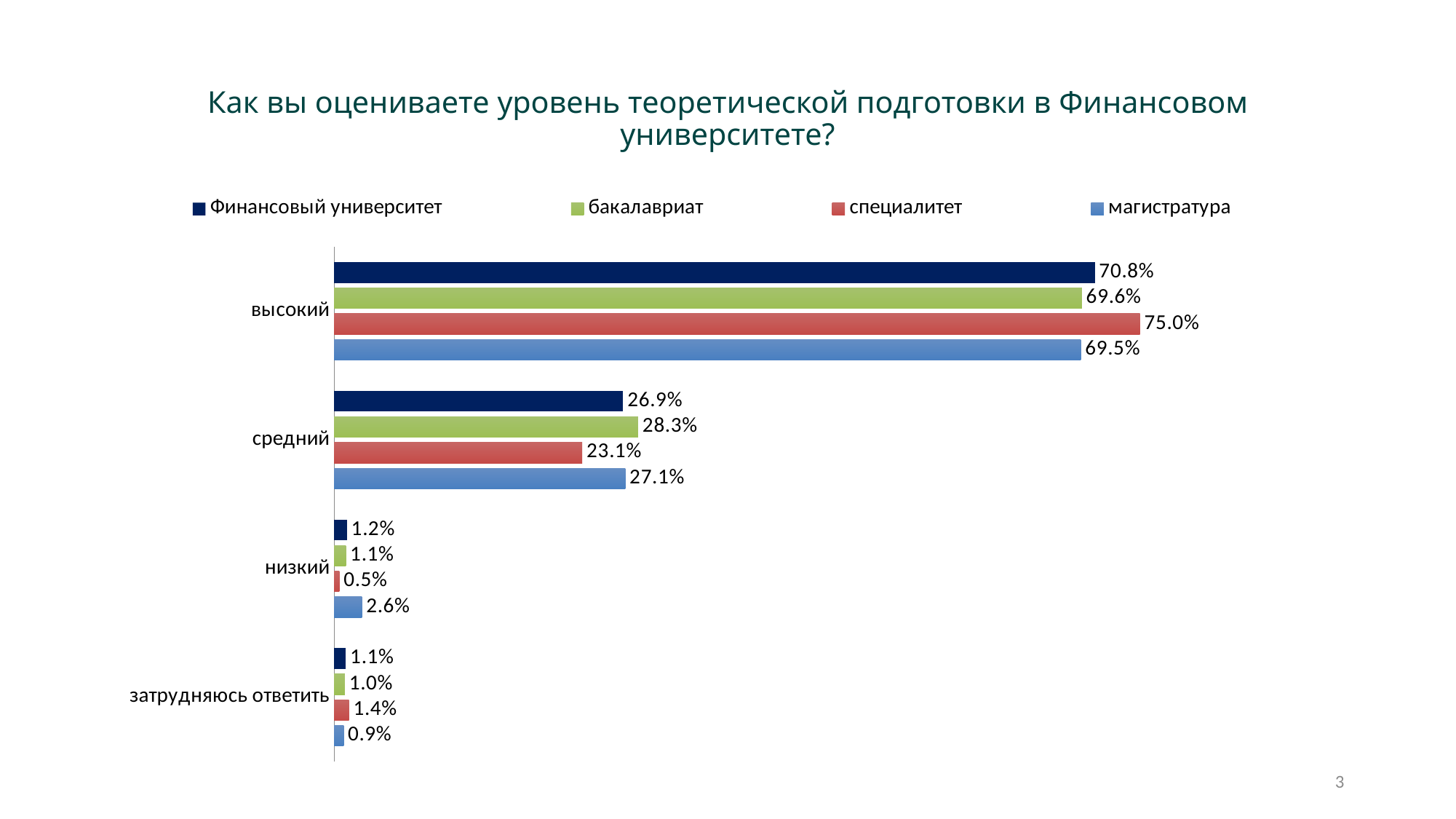
How many series does the legend list? 4 What kind of chart is shown on the slide? bar chart What is the value for специалитет in the высокий category? 75.0% Which series has the highest value in the высокий category? специалитет What is the value for бакалавриат in the низкий category? 1.1% Which series has the lowest value in the низкий category? специалитет What is the value for Финансовый университет in the затрудняюсь ответить category? 1.1% What is the difference between специалитет and бакалавриат in the высокий category? 5.4% Which is larger in the средний category: бакалавриат or специалитет? бакалавриат How many categories are shown on the chart? 4 What colour represents the магистратура series? light blue What is the value for магистратура in the средний category? 27.1%